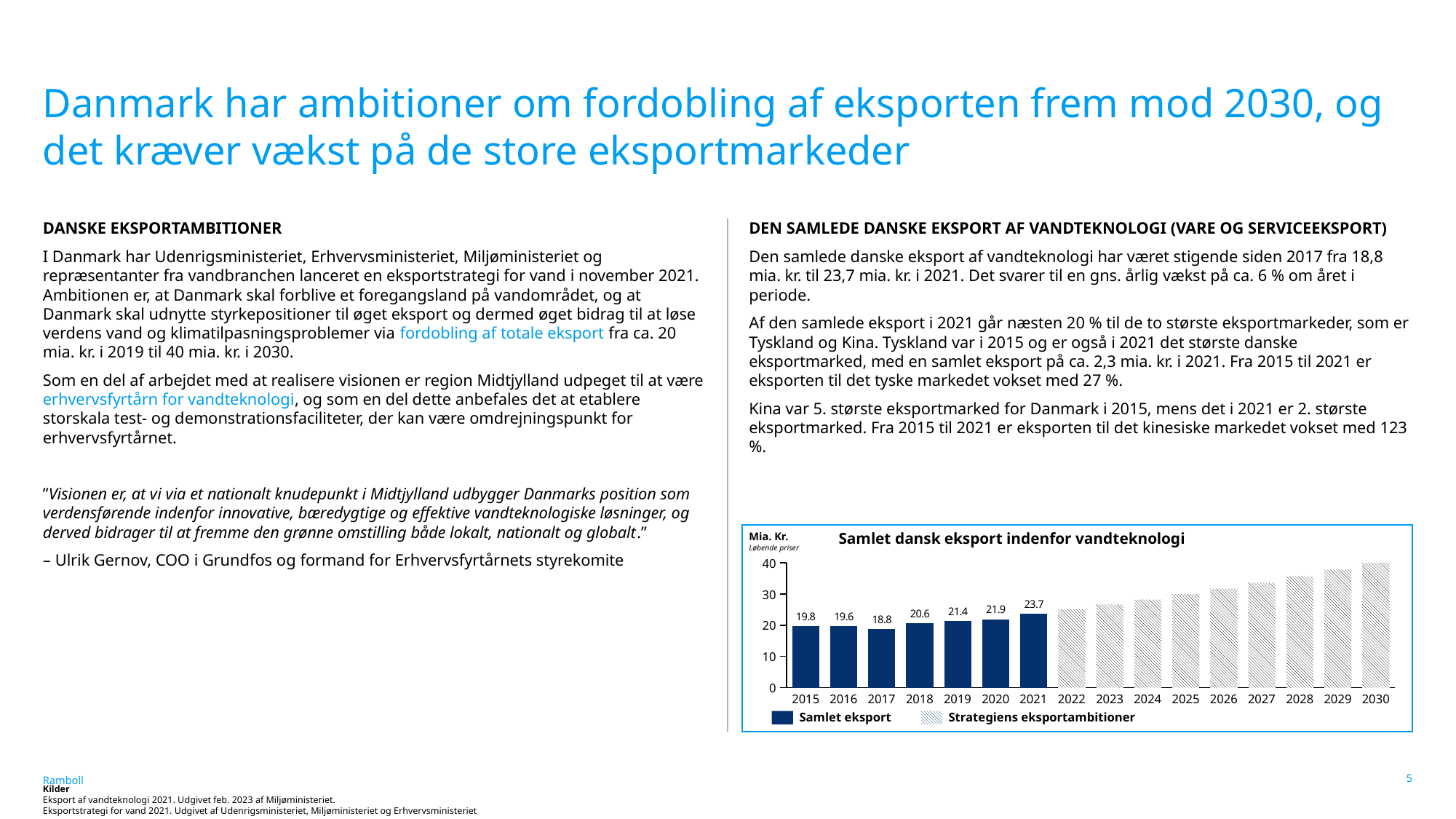
What is the difference between the Samlet eksport values for 2021 and 2015? 3.9 What is the title of the chart on the slide? Samlet dansk eksport indenfor vandteknologi Is the value for Strategiens eksportambitioner in 2030 greater or less than 30? greater What type of chart is shown on the slide? Bar chart What is the value of Samlet eksport for 2015? 19.8 What is the value of Samlet eksport for 2018? 20.6 Which year has the highest value of Samlet eksport among the labelled bars? 2021 How many years are shown on the x axis of the chart? 16 Which year has the lowest value of Samlet eksport among the labelled bars? 2017 How many series does the chart legend list? 2 What is the value of Samlet eksport for 2021? 23.7 Which is larger, the Samlet eksport value for 2016 or for 2019? 2019